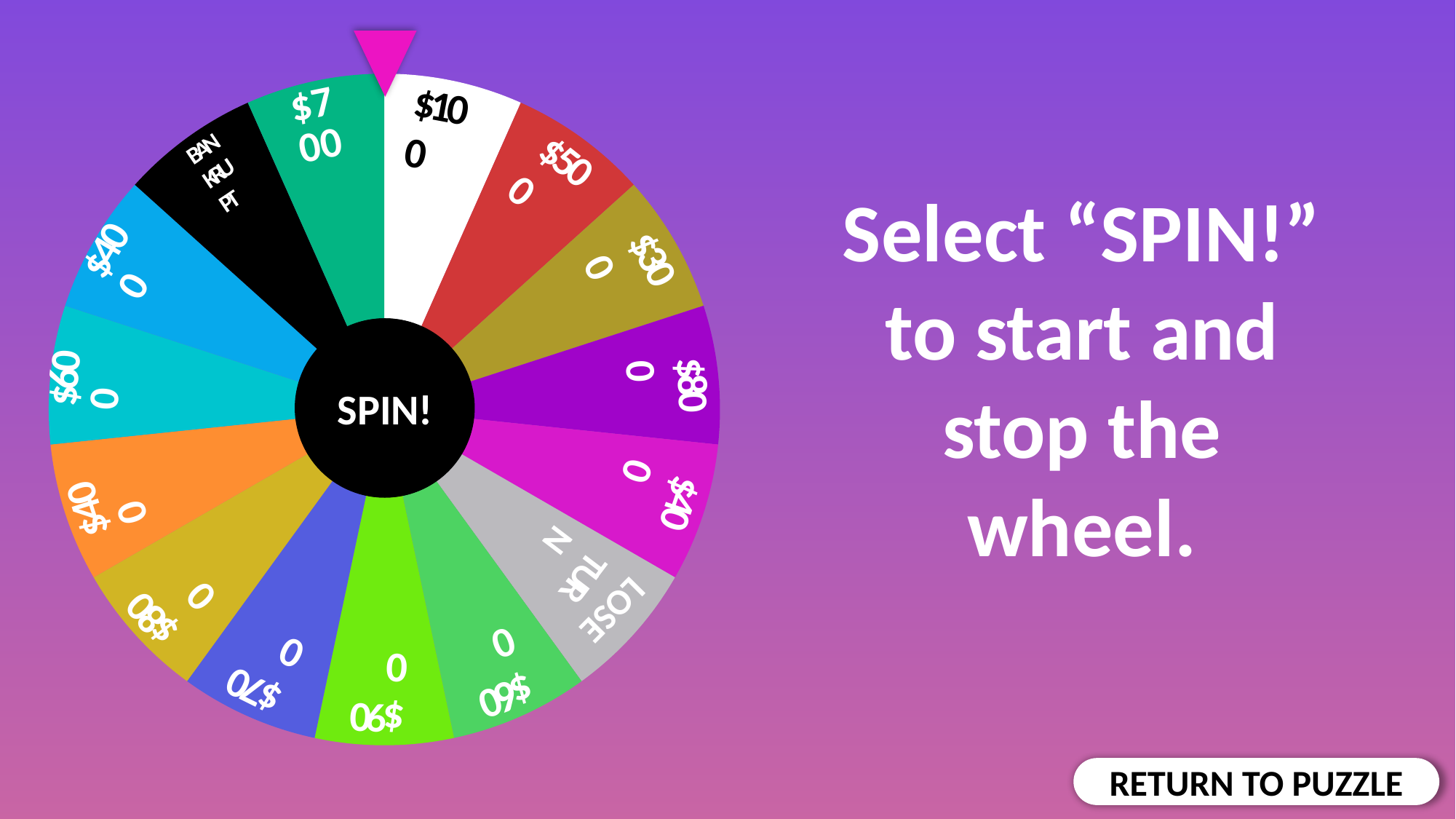
What text is shown in the centre of the wheel? SPIN! How many segments does the wheel on the slide have? 15 What is the lowest dollar value shown on the wheel? $300 What does the gray segment of the wheel say? LOSE A TURN What value is shown on the white segment of the wheel? $1000 What value is shown on the red segment of the wheel? $500 What value is shown on the lime green segment at the bottom of the wheel? $900 What is the highest dollar value shown on the wheel? $1000 What does the black segment of the wheel say? BANKRUPT